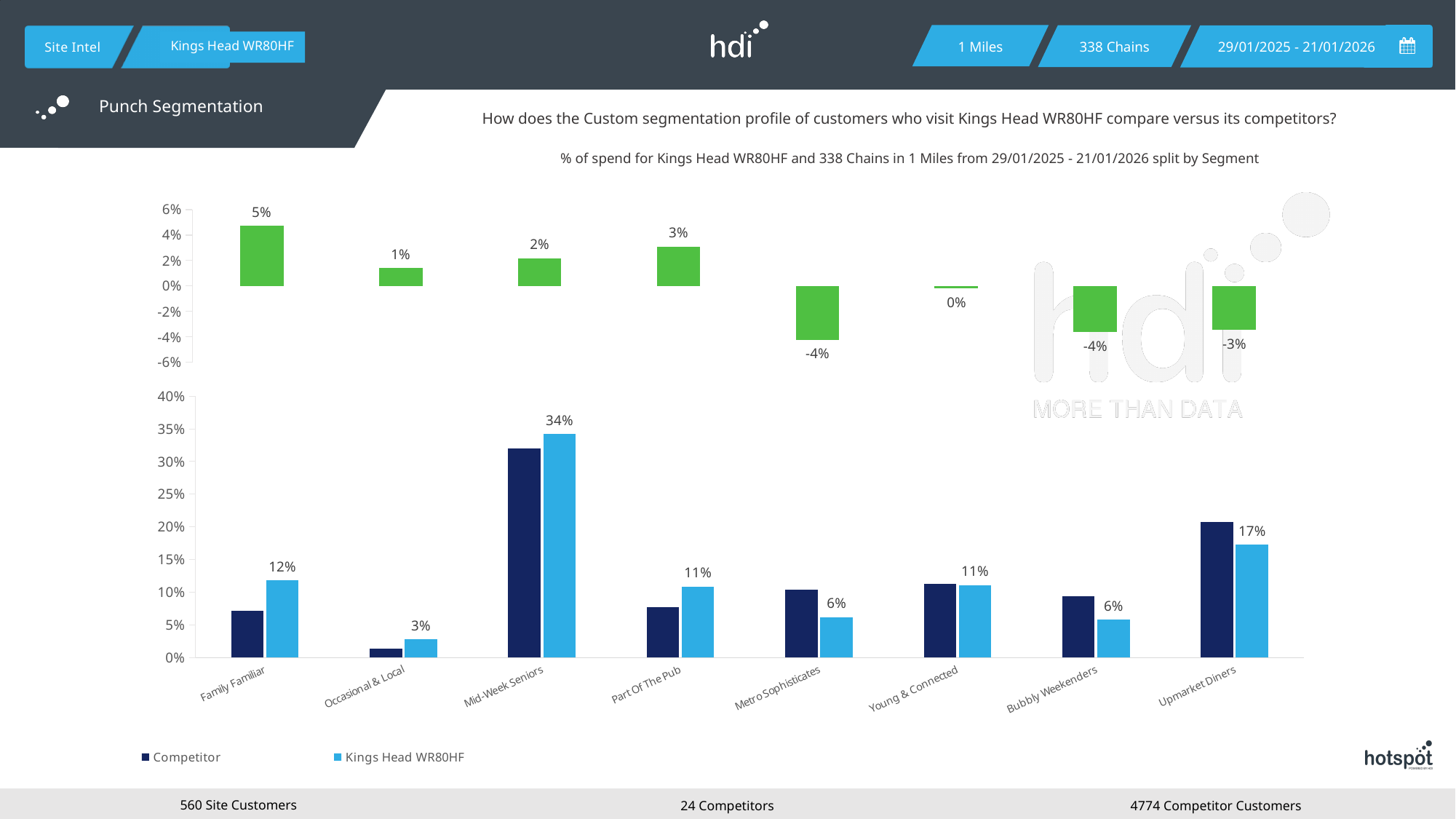
How many segments are shown on the x axis of the bottom chart? 8 In the top chart, what is the value shown for Metro Sophisticates? -4% What type of chart is the bottom chart? Bar chart In the bottom chart, what is the difference between the Kings Head WR80HF values for Mid-Week Seniors and Upmarket Diners? 17% In the bottom chart, is the Competitor value for Mid-Week Seniors greater or less than 30%? greater In the bottom chart, which segment has the highest Kings Head WR80HF value? Mid-Week Seniors In the bottom chart, for Upmarket Diners, which is larger: the Competitor bar or the Kings Head WR80HF bar? Competitor In the bottom chart, what is the Kings Head WR80HF value for Mid-Week Seniors? 34% In the top chart, which segment has the highest value? Family Familiar In the top chart, what is the value shown for Family Familiar? 5% How many series does the legend of the bottom chart list? 2 In the bottom chart, what is the Kings Head WR80HF value for Upmarket Diners? 17%